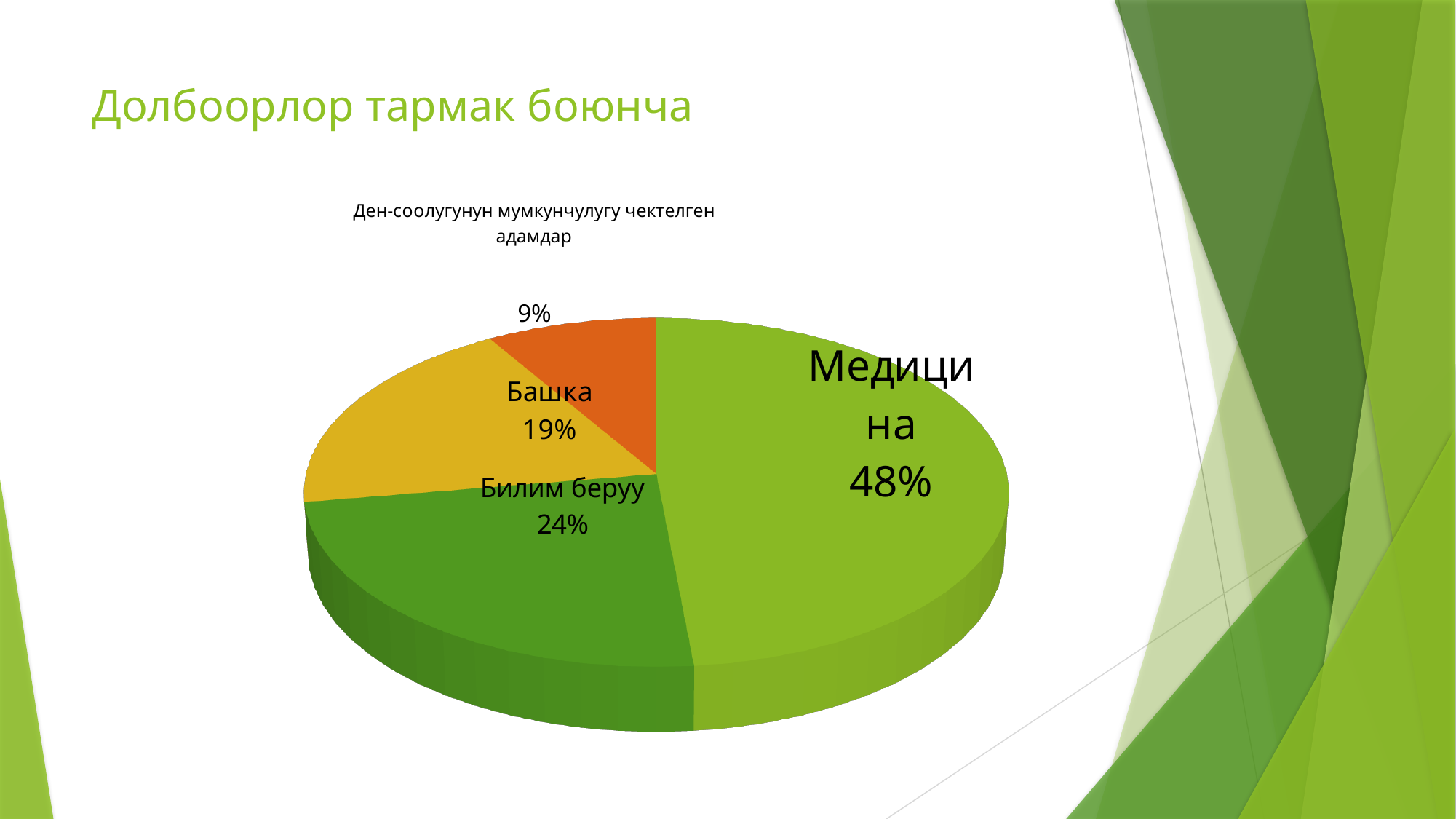
What is the difference in percentage points between Билим беруу and Башка? 5 What kind of chart is shown on the slide? pie chart What colour is the Медицина slice? green What percentage does the Билим беруу slice represent? 24% Which is larger, the Башка slice or the Билим беруу slice? Билим беруу Which category has the largest share of the pie? Медицина What is the smallest percentage shown on the pie chart? 9% What percentage is shown for the orange slice of the pie? 9% How many slices does the pie chart have? 4 What percentage does the Башка slice represent? 19% What percentage does the Медицина slice represent? 48% What is the difference in percentage points between Медицина and Билим беруу? 24